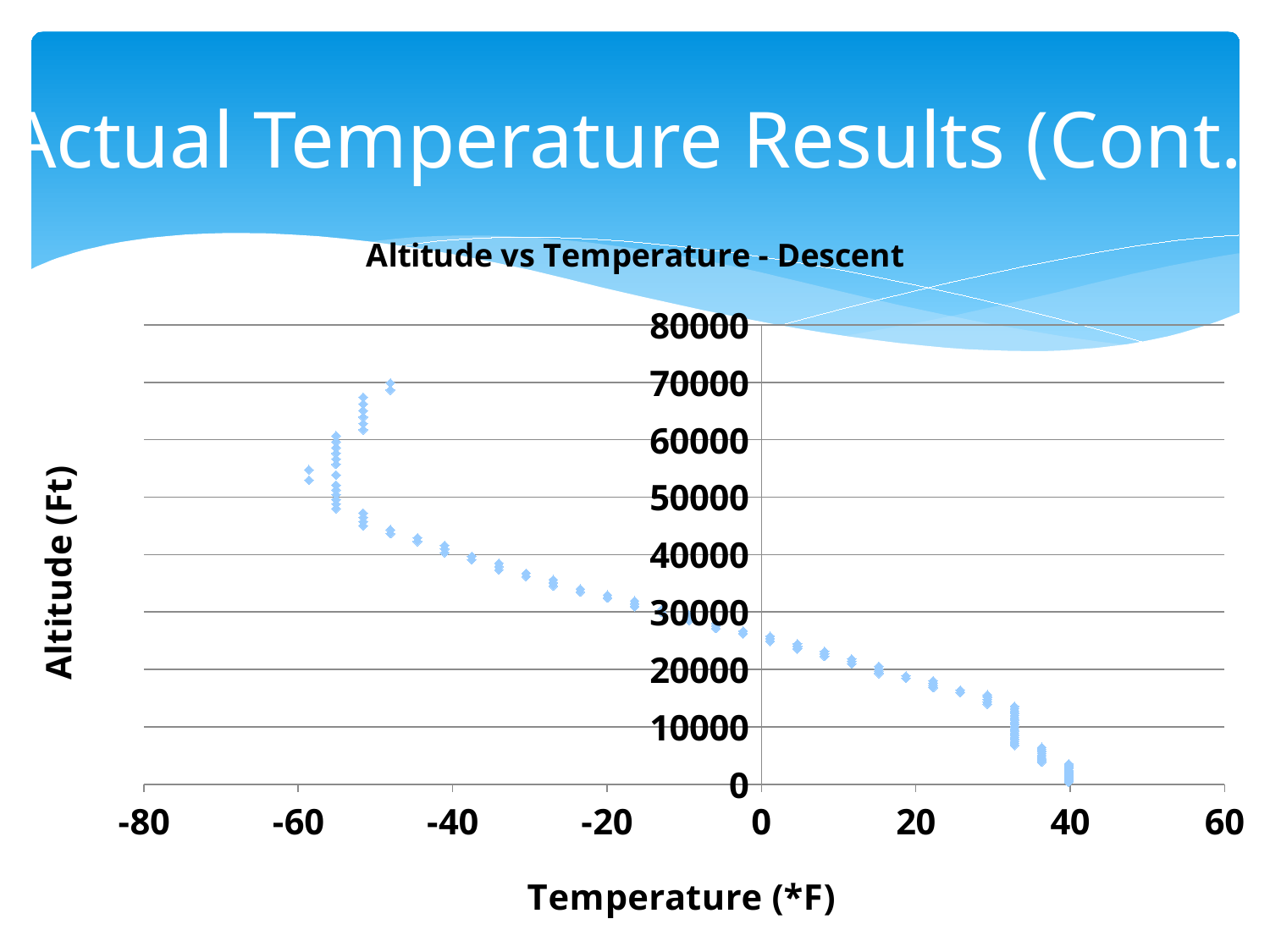
As temperature increases along the x axis, does altitude rise or fall? fall Is the altitude of the highest plotted point greater or less than 60000? greater Which has the higher altitude: the points at about -50 °F or the points at about 30 °F? the points at about -50 °F What is the title of the chart? Altitude vs Temperature - Descent Is the temperature of the points plotted near 0 ft altitude greater or less than 20? greater Is the temperature of the coldest plotted point greater or less than -40? less What is the lowest tick value shown on the x axis? -80 What kind of chart is shown on the slide? scatter chart What are the x-axis and y-axis labels of the chart? Temperature (*F) and Altitude (Ft) What is the highest tick value shown on the y axis? 80000